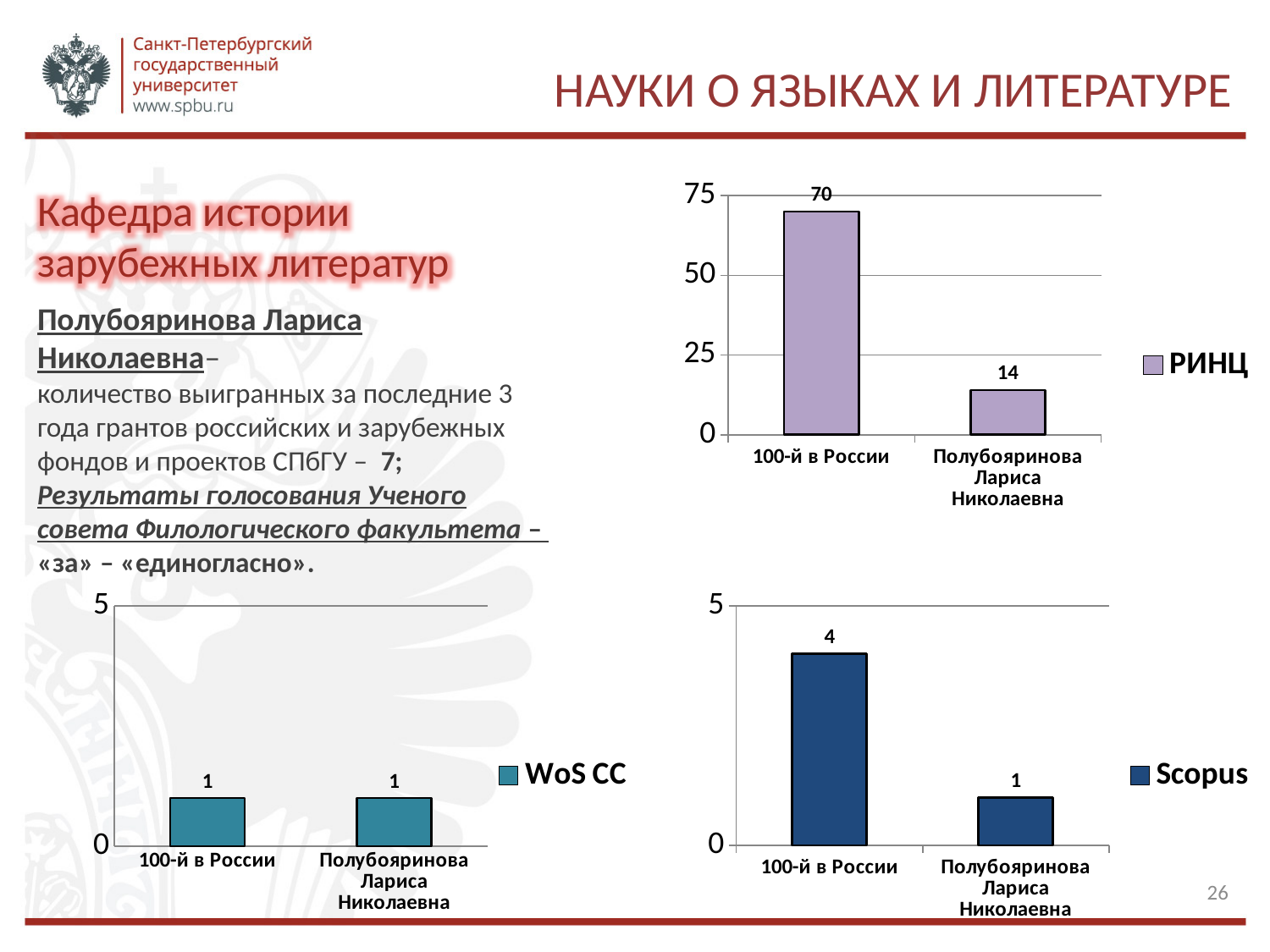
In the РИНЦ chart (top right), what is the value for 100-й в России? 70 In the РИНЦ chart (top right), what is the difference between the value for 100-й в России and the value for Полубояринова Лариса Николаевна? 56 In the Scopus chart (bottom right), what is the value for 100-й в России? 4 In the РИНЦ chart (top right), which category has the highest value? 100-й в России In the Scopus chart (bottom right), is the value for 100-й в России greater or less than the value for Полубояринова Лариса Николаевна? greater In the РИНЦ chart (top right), what is the value for Полубояринова Лариса Николаевна? 14 In the WoS CC chart (bottom left), what is the value for 100-й в России? 1 What kind of chart is the Scopus chart (bottom right)? bar chart How many categories are shown in the РИНЦ chart (top right)? 2 In the Scopus chart (bottom right), which category has the lowest value? Полубояринова Лариса Николаевна In the Scopus chart (bottom right), what is the value for Полубояринова Лариса Николаевна? 1 In the WoS CC chart (bottom left), what is the value for Полубояринова Лариса Николаевна? 1